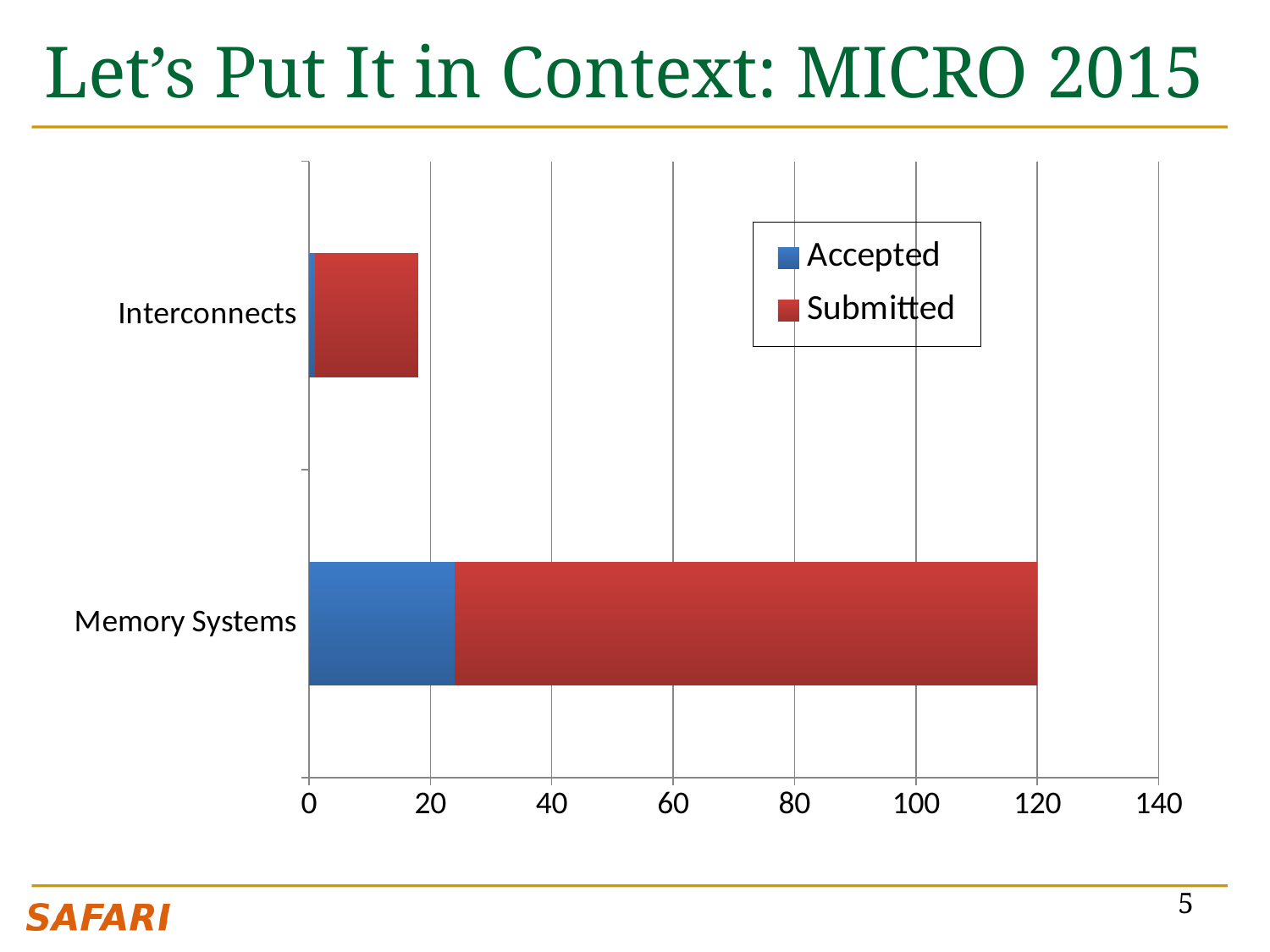
Which category has the longest total bar? Memory Systems Is the total bar length for Memory Systems greater or less than 100? greater Which category has the larger Submitted value, Memory Systems or Interconnects? Memory Systems Which category has the shortest total bar? Interconnects How many categories are shown on the chart? 2 Is the total bar length for Interconnects greater or less than 40? less What is the title of the slide containing the chart? Let's Put It in Context: MICRO 2015 Which colour represents the Submitted series in the legend? red What kind of chart is shown on the slide? bar chart Is the Accepted value for Memory Systems greater or less than 40? less How many series does the legend list? 2 Which category has the larger Accepted value, Memory Systems or Interconnects? Memory Systems